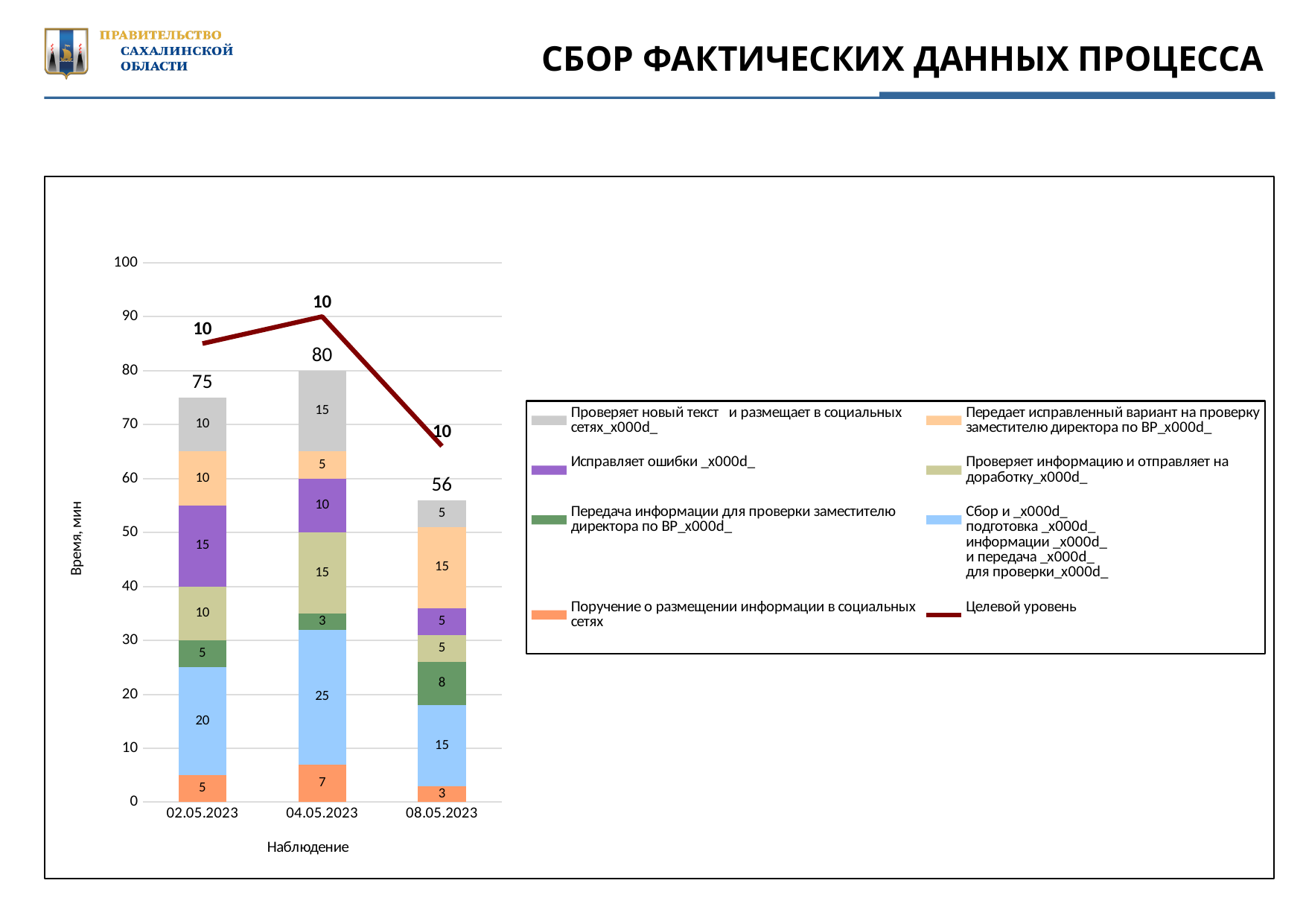
Is the 'Поручение о размещении информации в социальных сетях' segment larger for 04.05.2023 or for 08.05.2023? 04.05.2023 What is the total of the stacked bar for 04.05.2023? 80 What is the value of the 'Исправляет ошибки' segment for 02.05.2023? 15 Which observation date has the highest total bar? 04.05.2023 How many observation dates are shown on the x axis? 3 What is the label of the y axis? Время, мин How many entries does the legend list? 8 What is the value of the 'Сбор и подготовка информации и передача для проверки' segment for 04.05.2023? 25 What type of chart is shown on the slide? stacked bar chart with a line Which observation date has the lowest total bar? 08.05.2023 What is the total of the stacked bar for 08.05.2023? 56 What is the difference between the total bars for 04.05.2023 and 08.05.2023? 24